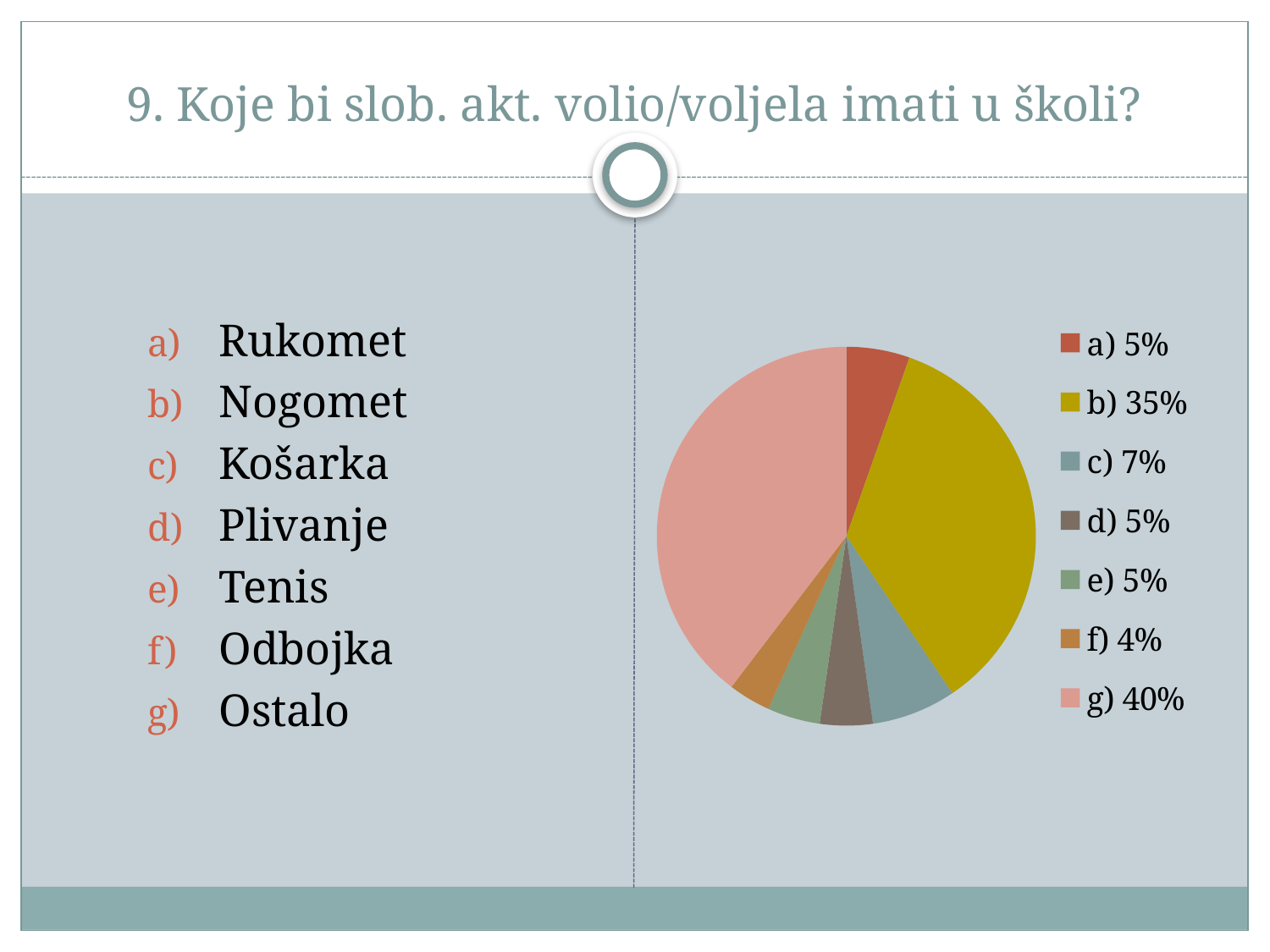
Which is larger, slice b) or slice c)? b) What is the difference in percentage points between slice g) and slice b)? 5 What percentage does the legend show for slice b)? 35% What percentage does the legend show for slice g)? 40% What is the difference in percentage points between slice c) and slice f)? 3 How many slices does the pie chart have? 7 What percentage does the legend show for slice f)? 4% What percentage does the legend show for slice c)? 7% Which slice has the smallest share of the pie? f) Which slice has the largest share of the pie? g) What kind of chart is shown on the slide? pie chart How many entries does the legend list? 7